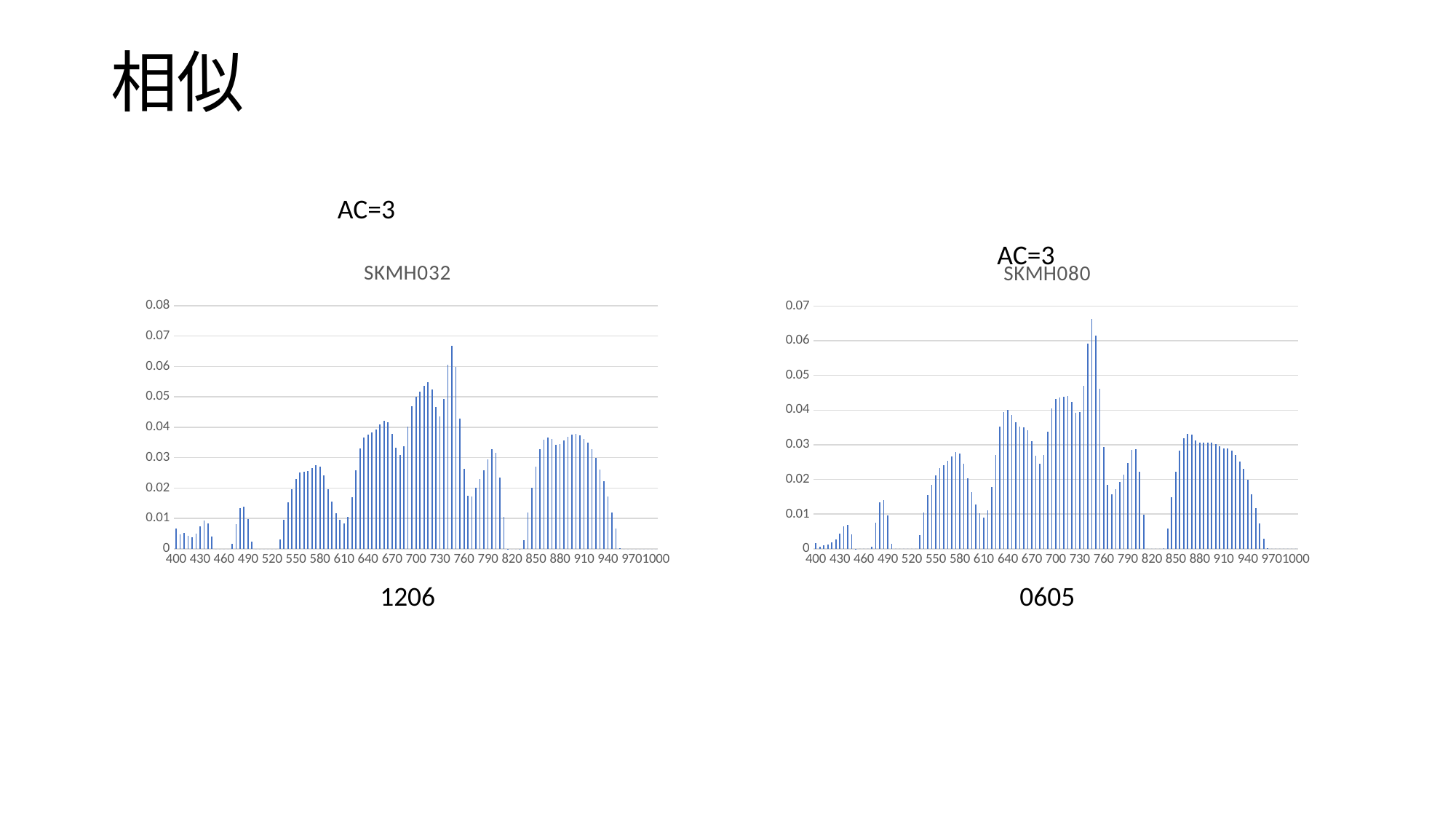
In the SKMH080 chart, is the value at 550 greater or less than 0.01? greater In the SKMH032 chart, is the tallest bar greater or less than 0.06? greater What kind of chart is the SKMH080 chart on the right? bar chart In the SKMH032 chart, is the value at 550 greater or less than 0.02? greater What is the title of the chart on the right side of the slide? SKMH080 What kind of chart is the SKMH032 chart on the left? bar chart What is the title of the chart on the left side of the slide? SKMH032